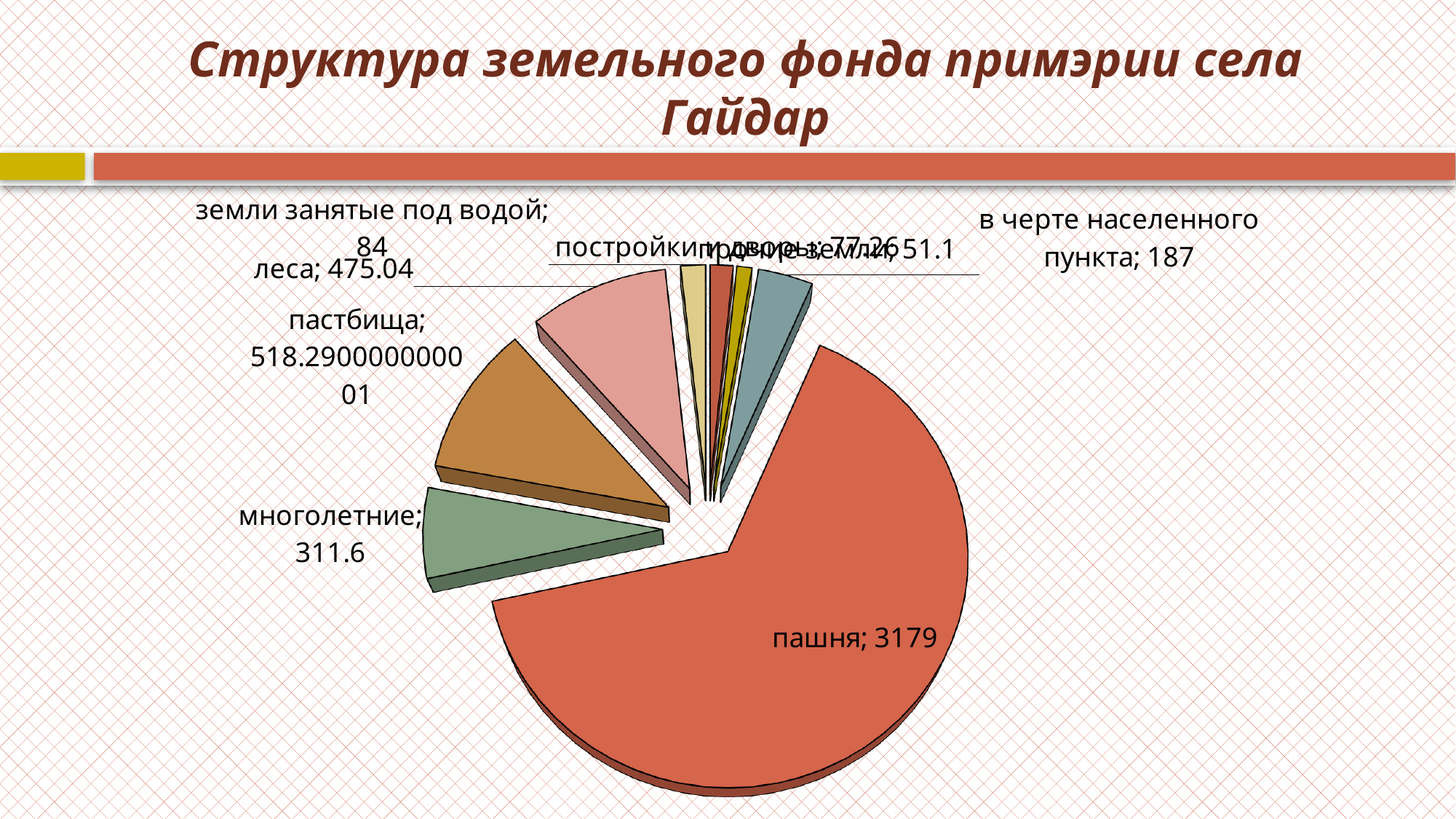
What is the value for в черте населенного пункта? 187 What kind of chart is shown on the slide? pie chart What is the value for земли занятые под водой? 84 Which is larger, многолетние or в черте населенного пункта? многолетние What is the value for пастбища? 518.290000000001 What is the difference between the values for в черте населенного пункта and земли занятые под водой? 103 What is the difference between the values for пашня and леса? 2703.96 What is the value for леса? 475.04 What is the value for многолетние? 311.6 Which category has the largest slice of the pie? пашня What is the value for пашня? 3179 Which is larger, леса or пастбища? пастбища